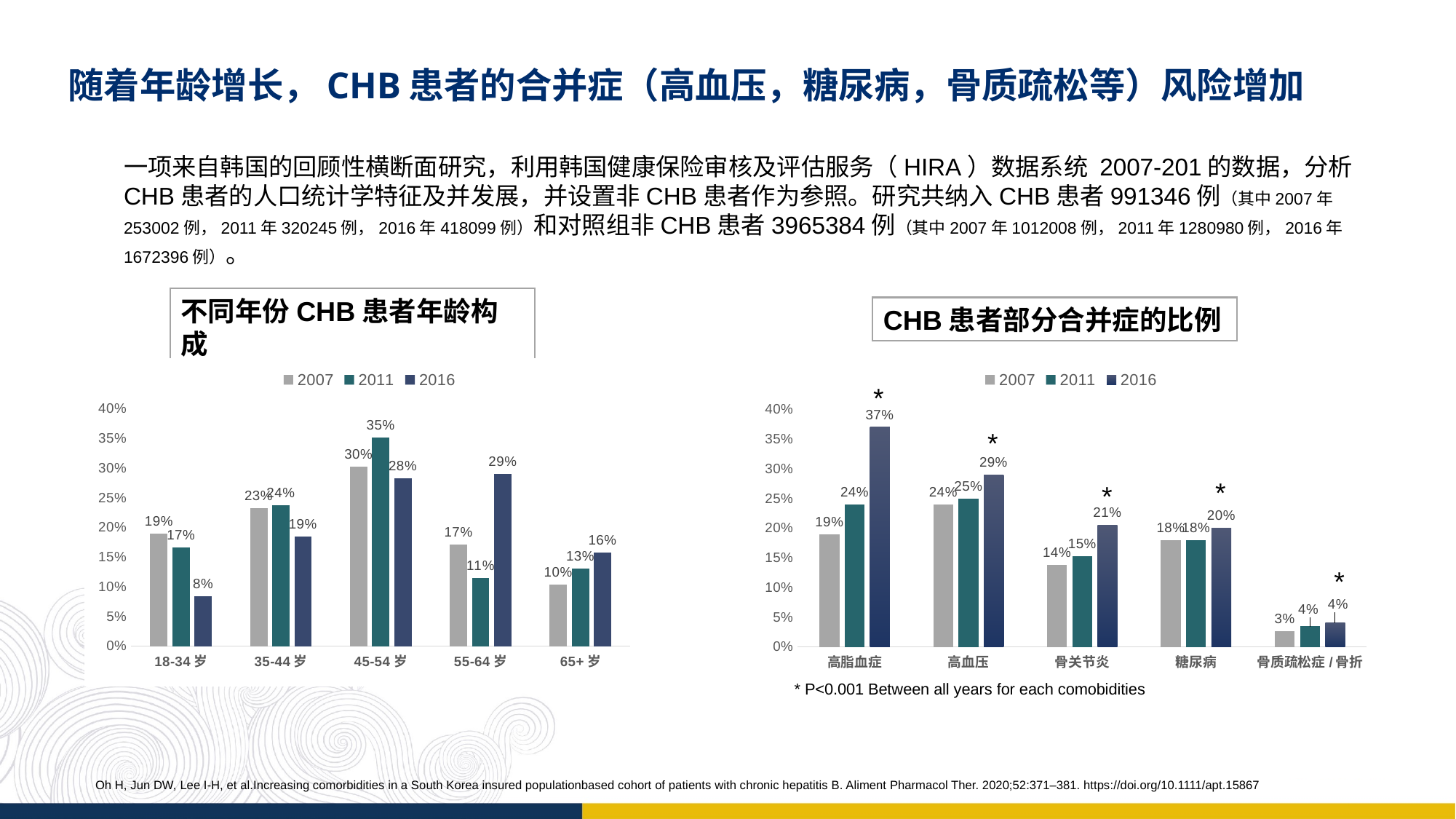
In the chart titled CHB 患者部分合并症的比例, which comorbidity has the lowest value for 2007? 骨质疏松症 / 骨折 How many series does the legend list in the chart titled CHB 患者部分合并症的比例? 3 In the chart titled 不同年份 CHB 患者年龄构成, what is the value for 2007 in the 45-54 岁 group? 30% In the chart titled CHB 患者部分合并症的比例, what is the value for 2016 for 高脂血症? 37% In the chart titled 不同年份 CHB 患者年龄构成, how many age groups are shown on the x axis? 5 In the chart titled CHB 患者部分合并症的比例, what is the value for 2007 for 骨关节炎? 14% In the chart titled CHB 患者部分合并症的比例, which is larger for 高血压: the 2007 value or the 2016 value? 2016 In the chart titled 不同年份 CHB 患者年龄构成, what is the difference between the 2007 and 2016 values for the 18-34 岁 group? 11% In the chart titled 不同年份 CHB 患者年龄构成, which age group has the highest value for 2011? 45-54 岁 In the chart titled 不同年份 CHB 患者年龄构成, what is the value for 2016 in the 55-64 岁 group? 29% In the chart titled 不同年份 CHB 患者年龄构成, which age group has the lowest value for 2016? 18-34 岁 In the chart titled CHB 患者部分合并症的比例, what is the difference between the 2016 and 2007 values for 高脂血症? 18%